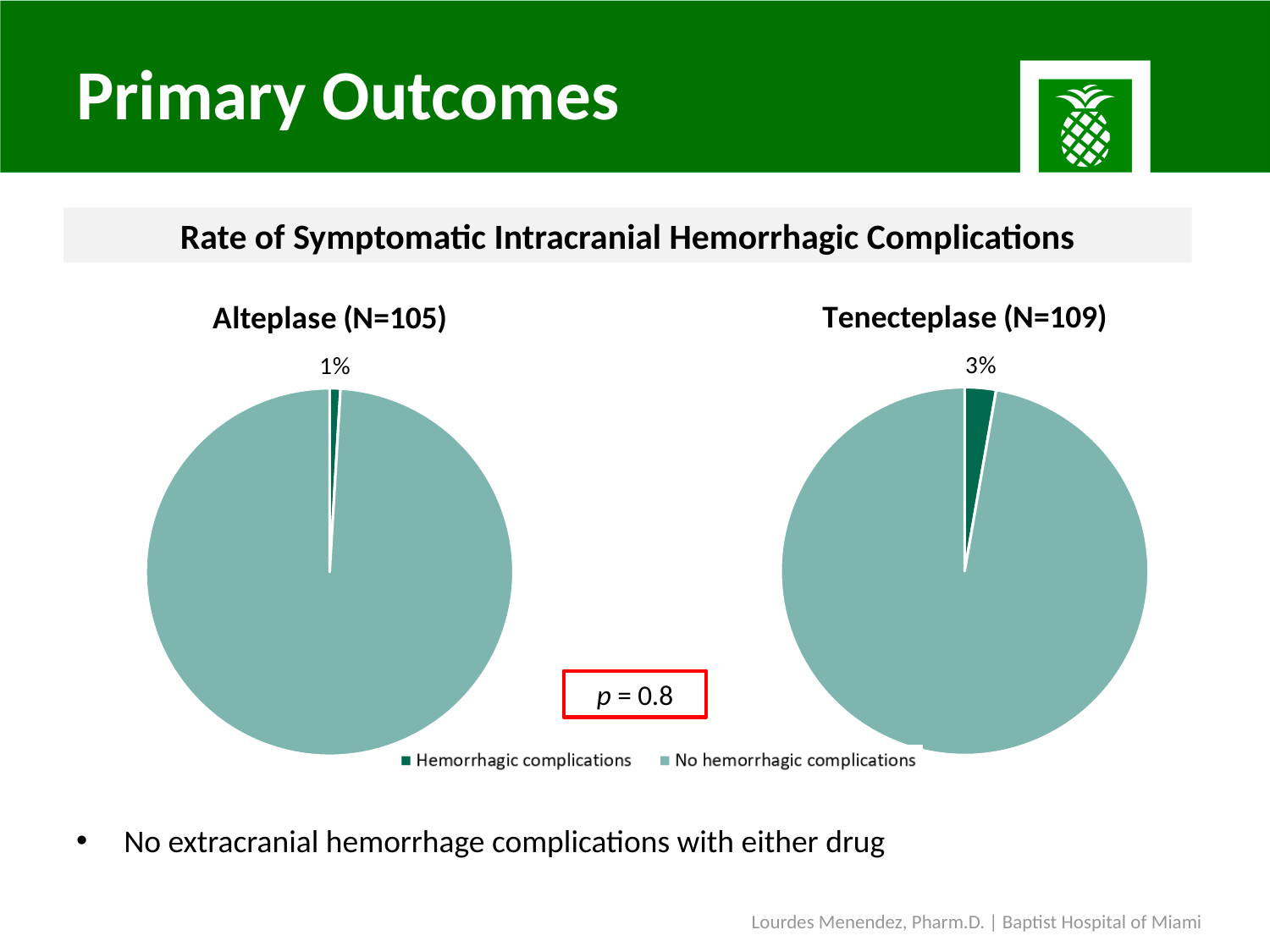
How many entries does the shared legend below the pie charts list? 2 In the Alteplase (N=105) pie chart, which slice is the largest? No hemorrhagic complications What is the difference in the hemorrhagic complications percentage between the Tenecteplase pie chart and the Alteplase pie chart? 2 percentage points How many pie charts are shown on the slide? 2 How many slices does the Alteplase (N=105) pie chart have? 2 What is the title of the pie chart on the left side of the slide? Alteplase (N=105) What is the title of the pie chart on the right side of the slide? Tenecteplase (N=109) In the Tenecteplase (N=109) pie chart, what percentage of patients had hemorrhagic complications? 3% Which drug's pie chart shows the larger share of hemorrhagic complications, Alteplase or Tenecteplase? Tenecteplase What kind of chart is used to show the rate of symptomatic intracranial hemorrhagic complications for each drug? Pie chart In the Alteplase (N=105) pie chart, what percentage of patients had hemorrhagic complications? 1% In the Tenecteplase (N=109) pie chart, which slice is the smallest? Hemorrhagic complications